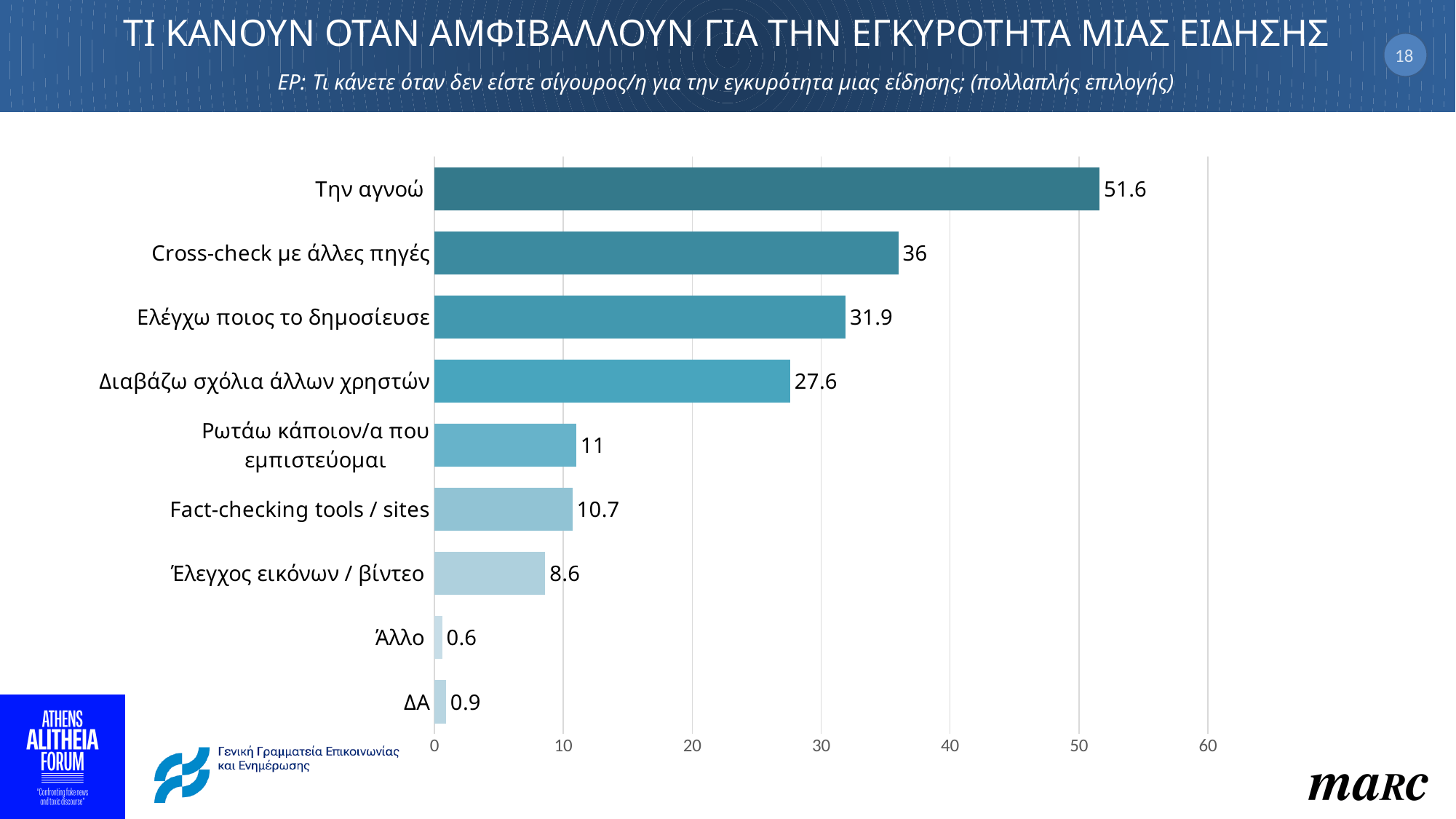
Which category has the highest value? Την αγνοώ Is the value for "Διαβάζω σχόλια άλλων χρηστών" greater or less than 30? less What is the difference between the values for "Την αγνοώ" and "Cross-check με άλλες πηγές"? 15.6 How many categories are shown in the chart? 9 What is the value for "Cross-check με άλλες πηγές"? 36 Which is larger: the value for "Ελέγχω ποιος το δημοσίευσε" or "Διαβάζω σχόλια άλλων χρηστών"? Ελέγχω ποιος το δημοσίευσε Which category has the lowest value? Άλλο What is the value for "Fact-checking tools / sites"? 10.7 What is the value for "Έλεγχος εικόνων / βίντεο"? 8.6 What is the value for "Την αγνοώ"? 51.6 What kind of chart is shown on the slide? bar chart What is the highest tick value shown on the horizontal axis? 60